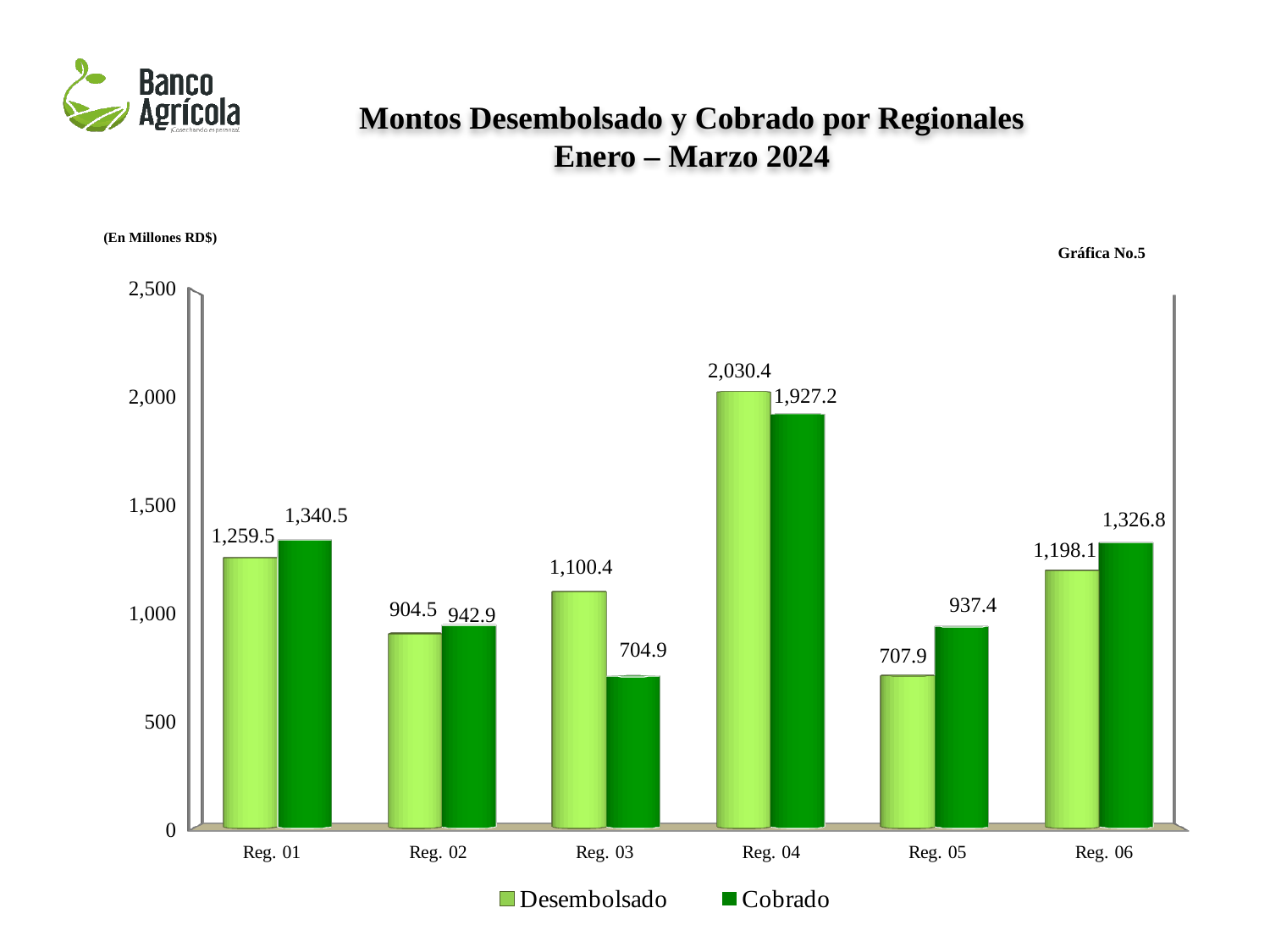
What is the difference between the Desembolsado and Cobrado values for Reg. 04? 103.2 For Reg. 05, which is larger, Desembolsado or Cobrado? Cobrado What is the Desembolsado value for Reg. 06? 1,198.1 What unit is stated above the chart? En Millones RD$ Which region has the lowest Desembolsado value? Reg. 05 What is the difference between the Desembolsado and Cobrado values for Reg. 03? 395.5 How many series does the legend list? 2 What is the Desembolsado value for Reg. 04? 2,030.4 What kind of chart is shown on the slide? Bar chart How many regions are shown on the x axis? 6 What is the Cobrado value for Reg. 03? 704.9 Which region has the highest Cobrado value? Reg. 04